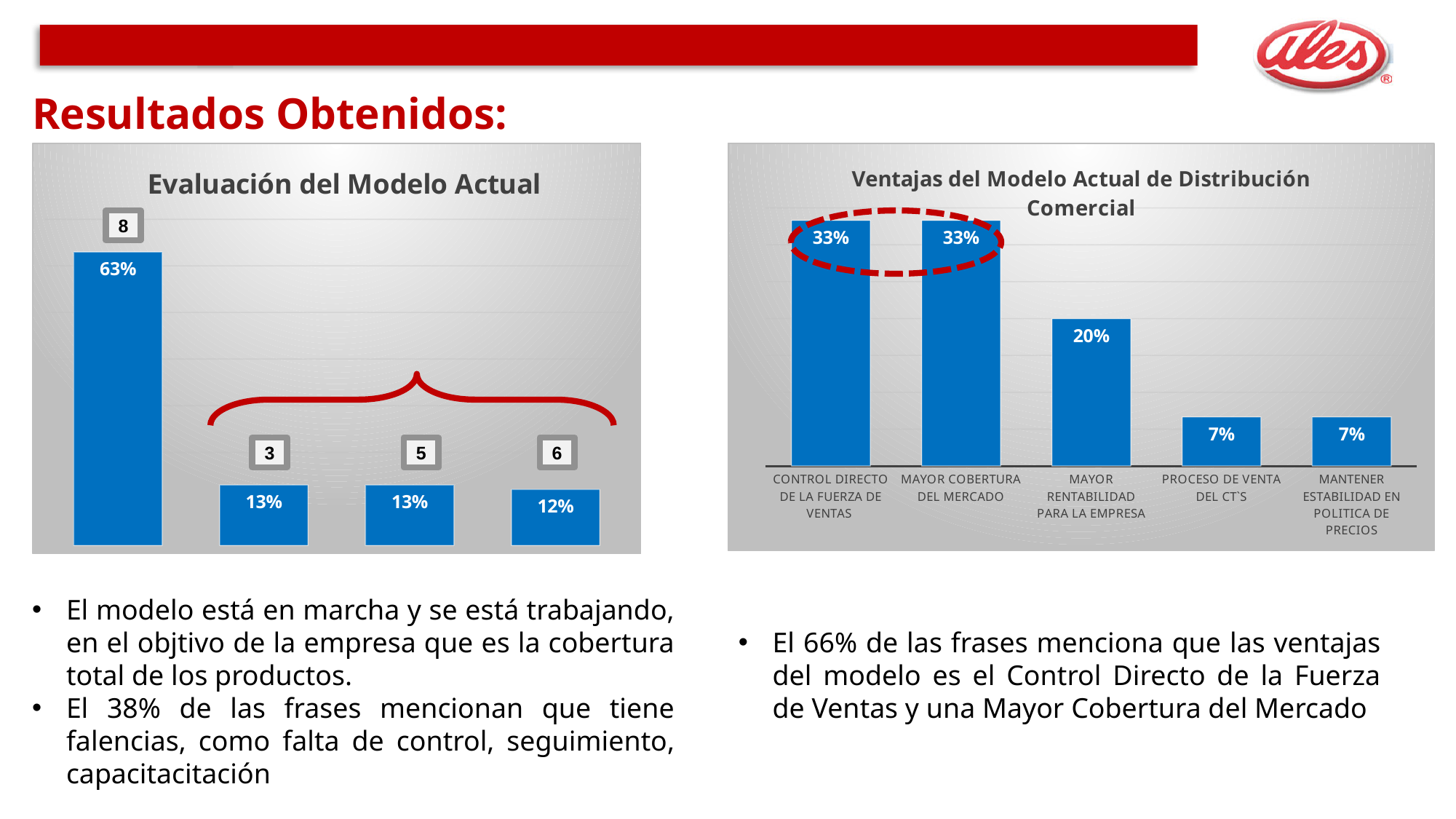
In the chart 'Evaluación del Modelo Actual', what is the difference between the tallest bar and the shortest bar? 51 percentage points In the chart 'Ventajas del Modelo Actual de Distribución Comercial', what is the value for 'Mayor Rentabilidad para la Empresa'? 20% In the chart 'Ventajas del Modelo Actual de Distribución Comercial', which is larger: 'Mayor Rentabilidad para la Empresa' or 'Mantener Estabilidad en Politica de Precios'? Mayor Rentabilidad para la Empresa What kind of chart is 'Ventajas del Modelo Actual de Distribución Comercial'? Bar chart In the chart 'Ventajas del Modelo Actual de Distribución Comercial', what is the difference between 'Mayor Cobertura del Mercado' and 'Mayor Rentabilidad para la Empresa'? 13 percentage points In the chart 'Ventajas del Modelo Actual de Distribución Comercial', what is the value for 'Proceso de Venta del CT`S'? 7% In the chart 'Evaluación del Modelo Actual', what is the value of the shortest bar? 12% In the chart 'Ventajas del Modelo Actual de Distribución Comercial', what is the value for 'Control Directo de la Fuerza de Ventas'? 33% In the chart 'Evaluación del Modelo Actual', what is the value of the tallest bar? 63% In the chart 'Evaluación del Modelo Actual', how many bars are plotted? 4 In the chart 'Ventajas del Modelo Actual de Distribución Comercial', how many bars show a value of 33%? 2 In the chart 'Ventajas del Modelo Actual de Distribución Comercial', how many categories are plotted? 5